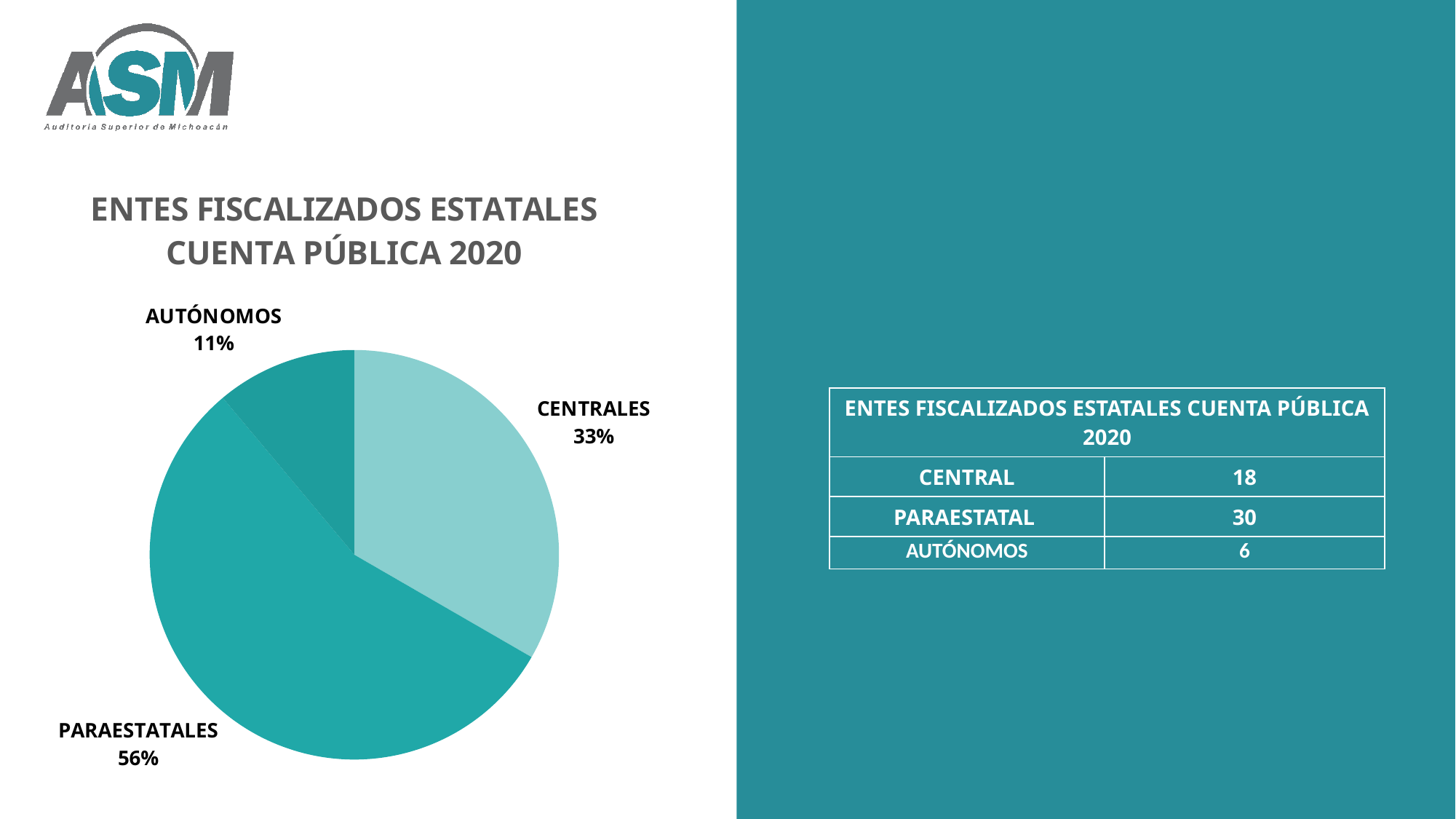
Which category has the smallest slice in the pie chart? AUTÓNOMOS What kind of chart is shown on the slide? Pie chart How many slices does the pie chart have? 3 Which category has the largest slice in the pie chart? PARAESTATALES Which slice is larger, CENTRALES or AUTÓNOMOS? CENTRALES Which slice of the pie chart is the lightest shade of teal? CENTRALES What is the title of the chart? ENTES FISCALIZADOS ESTATALES CUENTA PÚBLICA 2020 What share of the pie chart does CENTRALES represent? 33% What share of the pie chart does AUTÓNOMOS represent? 11% What is the difference in percentage points between the CENTRALES and AUTÓNOMOS slices? 22% What share of the pie chart does PARAESTATALES represent? 56% What is the difference in percentage points between the PARAESTATALES and CENTRALES slices? 23%